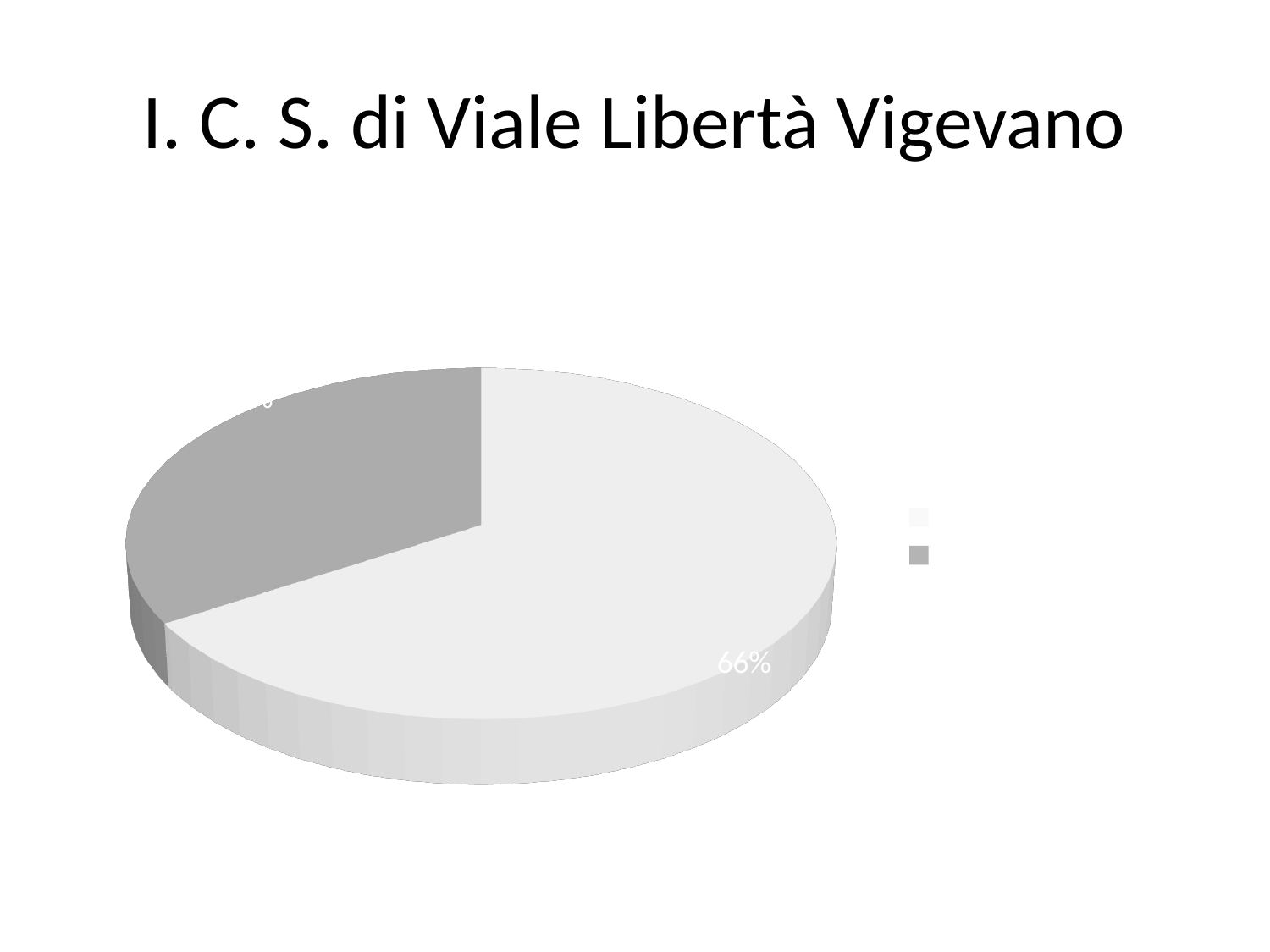
Is the pie chart drawn in 3D or flat 2D? 3D What kind of chart is shown on the slide? pie chart Is the light grey slice of the pie chart more or less than half of the pie? more What is the title of the slide containing the pie chart? I. C. S. di Viale Libertà Vigevano How many entries does the legend of the pie chart list? 2 What share of the pie does the light grey slice represent? 66% What percentage is printed on the light grey slice of the pie chart? 66% Which slice of the pie chart is the smallest, the light grey one or the dark grey one? the dark grey one How many slices does the pie chart have? 2 Is the light grey slice of the pie chart larger or smaller than the dark grey slice? larger Which slice of the pie chart is the largest, the light grey one or the dark grey one? the light grey one